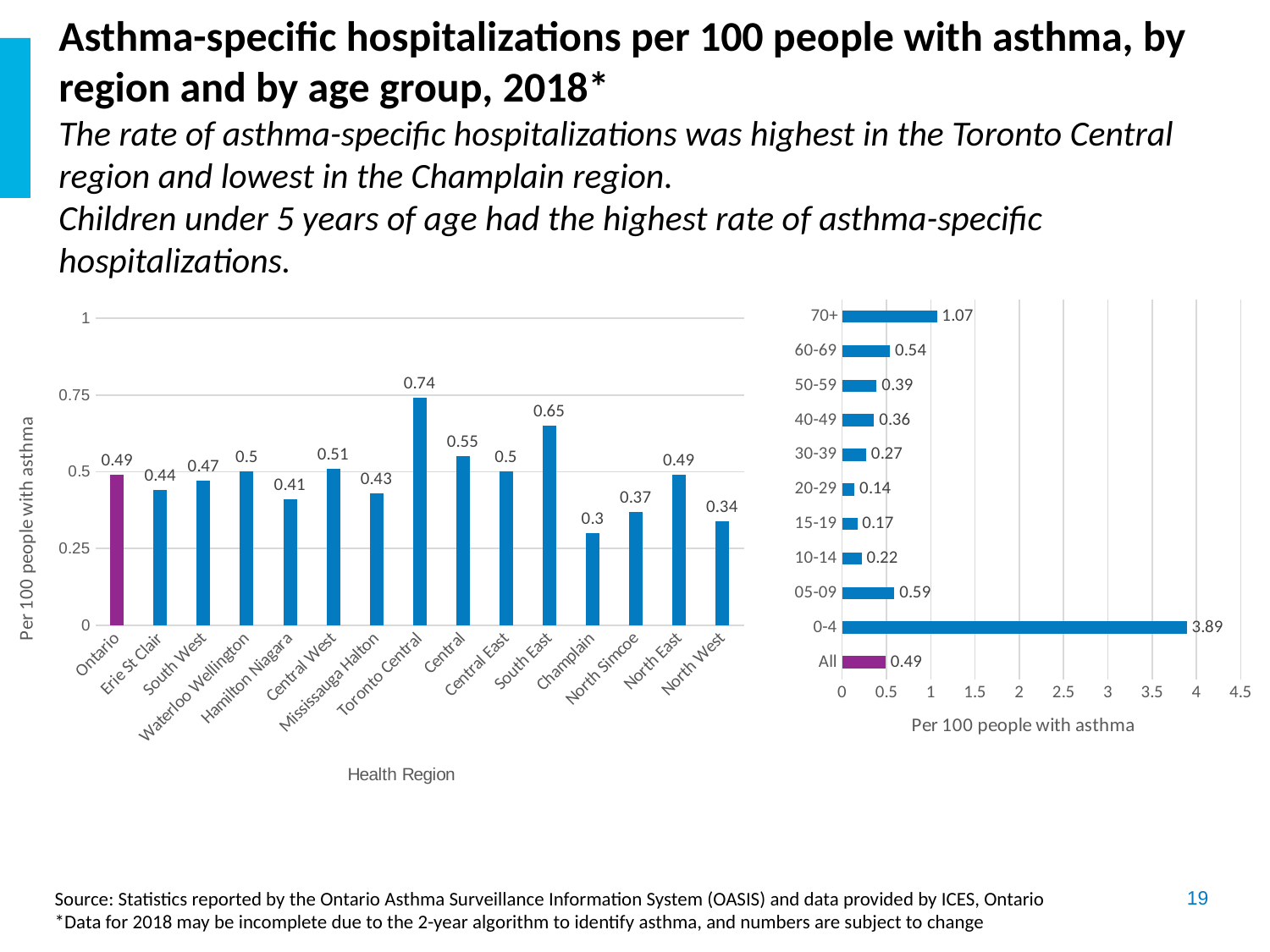
In the left chart (by health region), which health region has the lowest value? Champlain In the left chart (by health region), which health region has the highest value? Toronto Central What kind of chart is the right chart (by age group)? Bar chart In the right chart (by age group), which age group has the lowest value? 20-29 In the right chart (by age group), what is the value for the 70+ age group? 1.07 In the left chart (by health region), how many health regions (bars) are shown, including Ontario? 15 In the right chart (by age group), what is the value for the 0-4 age group? 3.89 In the left chart (by health region), what is the value for Champlain? 0.3 In the left chart (by health region), what is the difference between the values for Toronto Central and Champlain? 0.44 In the right chart (by age group), what is the difference between the values for 0-4 and 05-09? 3.3 In the left chart (by health region), what is the value for Toronto Central? 0.74 In the left chart (by health region), which is larger, the value for South East or the value for Central? South East